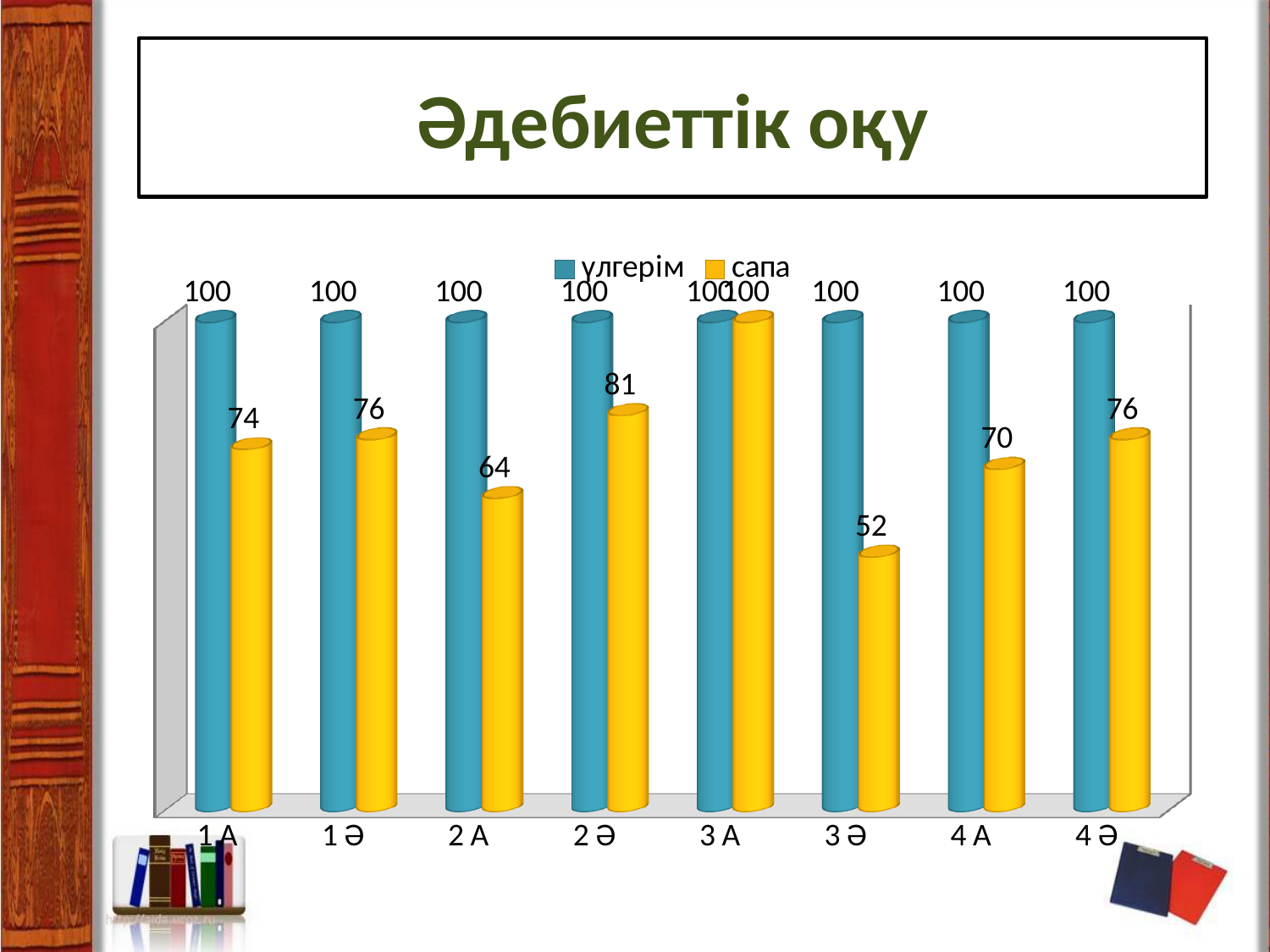
What is the difference between the үлгерім and сапа values for 3 Ә? 48 What is the сапа value for 2 А? 64 How many categories are shown on the x axis? 8 What is the үлгерім value for 4 А? 100 What kind of chart is shown on the slide? Bar chart Which is larger, the сапа value for 1 А or the сапа value for 4 А? 1 А What is the difference between the сапа values for 2 Ә and 2 А? 17 How many series does the legend list? 2 What is the сапа value for 3 Ә? 52 Which category has the lowest сапа value? 3 Ә Which category has the highest сапа value? 3 А What is the сапа value for 2 Ә? 81